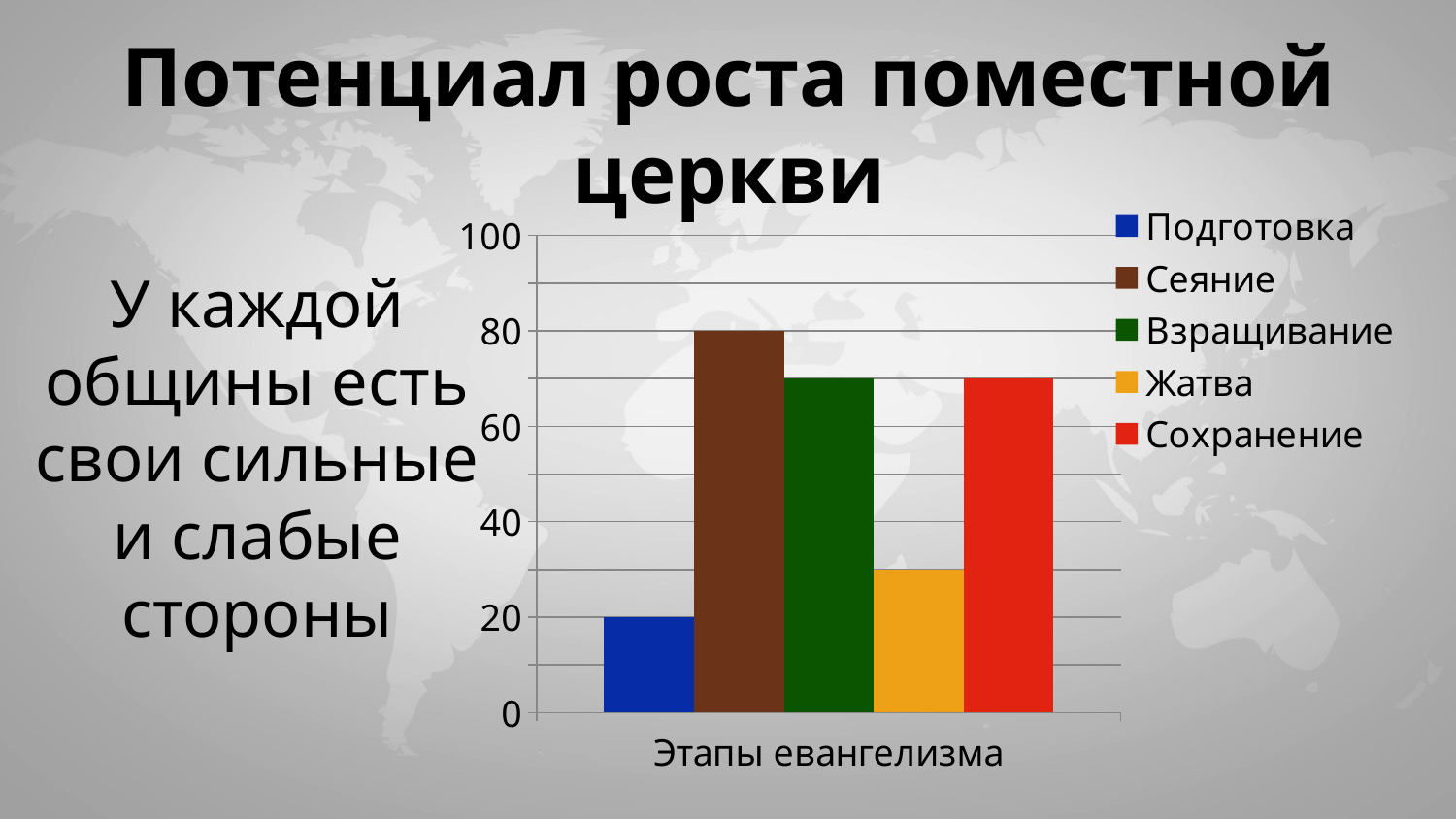
Is the value for Взращивание greater or less than 60? greater What is the value of the Подготовка bar? 20 Is the value for Жатва greater or less than 40? less Is the value for Сохранение greater or less than 80? less Which series has the lowest bar? Подготовка What kind of chart is shown on the slide? Bar chart Which is larger, the Сеяние bar or the Взращивание bar? Сеяние What is the value of the Сеяние bar? 80 What is the label on the x axis of the chart? Этапы евангелизма How many series does the legend list? 5 Which series has the highest bar? Сеяние What is the difference between the Сеяние bar and the Подготовка bar? 60